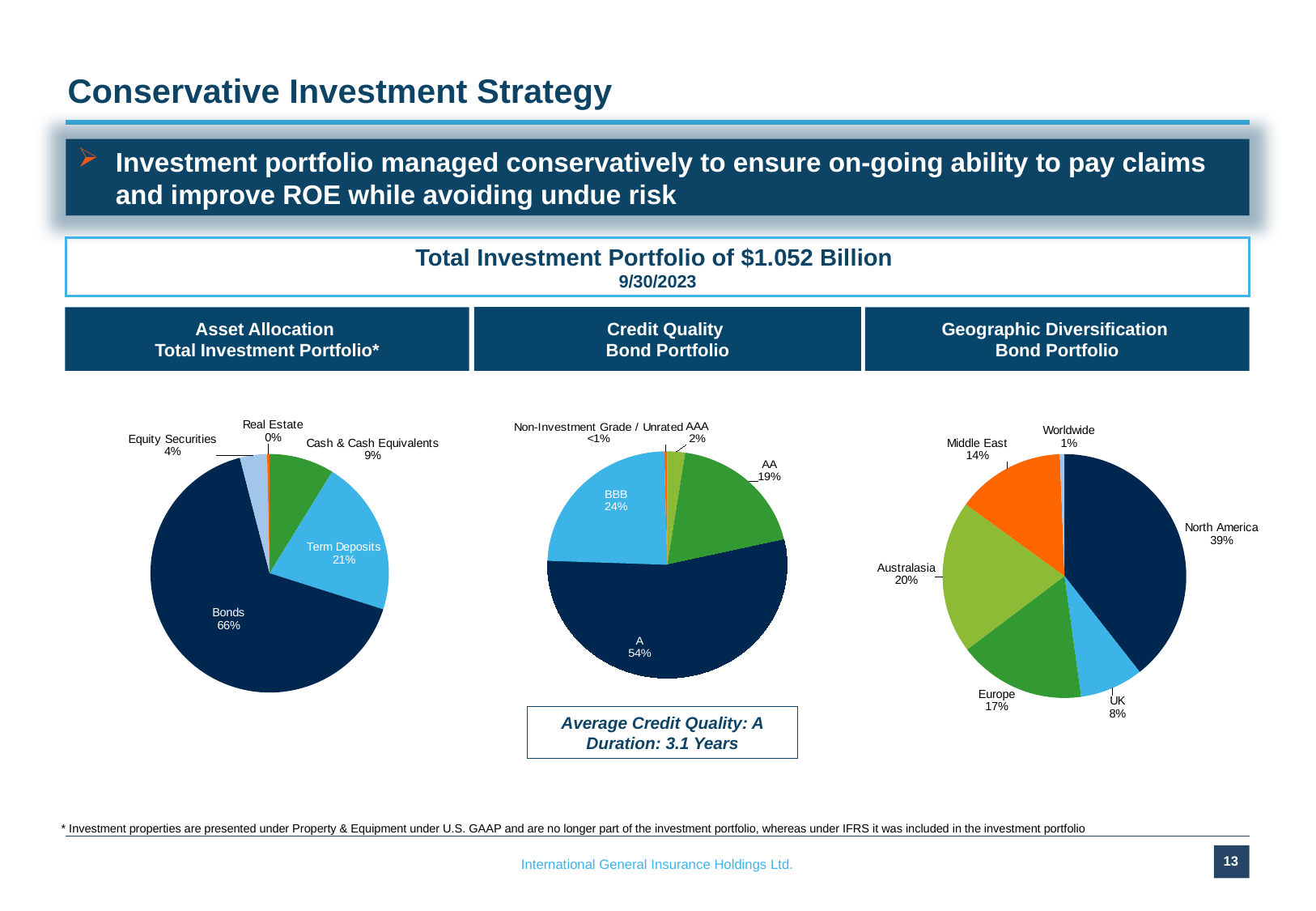
In the Asset Allocation pie chart, what share is Term Deposits? 21% In the Geographic Diversification pie chart, what is the difference between the Australasia share and the Europe share? 3% In the Credit Quality pie chart, what share is rated BBB? 24% What type of chart is used for the Geographic Diversification of the bond portfolio? Pie chart In the Geographic Diversification pie chart, what share of the bond portfolio is North America? 39% In the Geographic Diversification pie chart, which region has the smallest share? Worldwide In the Credit Quality pie chart, what is the difference between the AA share and the AAA share? 17% In the Asset Allocation pie chart, what share of the total investment portfolio is Bonds? 66% In the Credit Quality pie chart, which is larger, the AA share or the BBB share? BBB In the Asset Allocation pie chart, how many categories are shown? 5 In the Credit Quality pie chart, what share of the bond portfolio is rated A? 54% In the Asset Allocation pie chart, which category has the largest share? Bonds